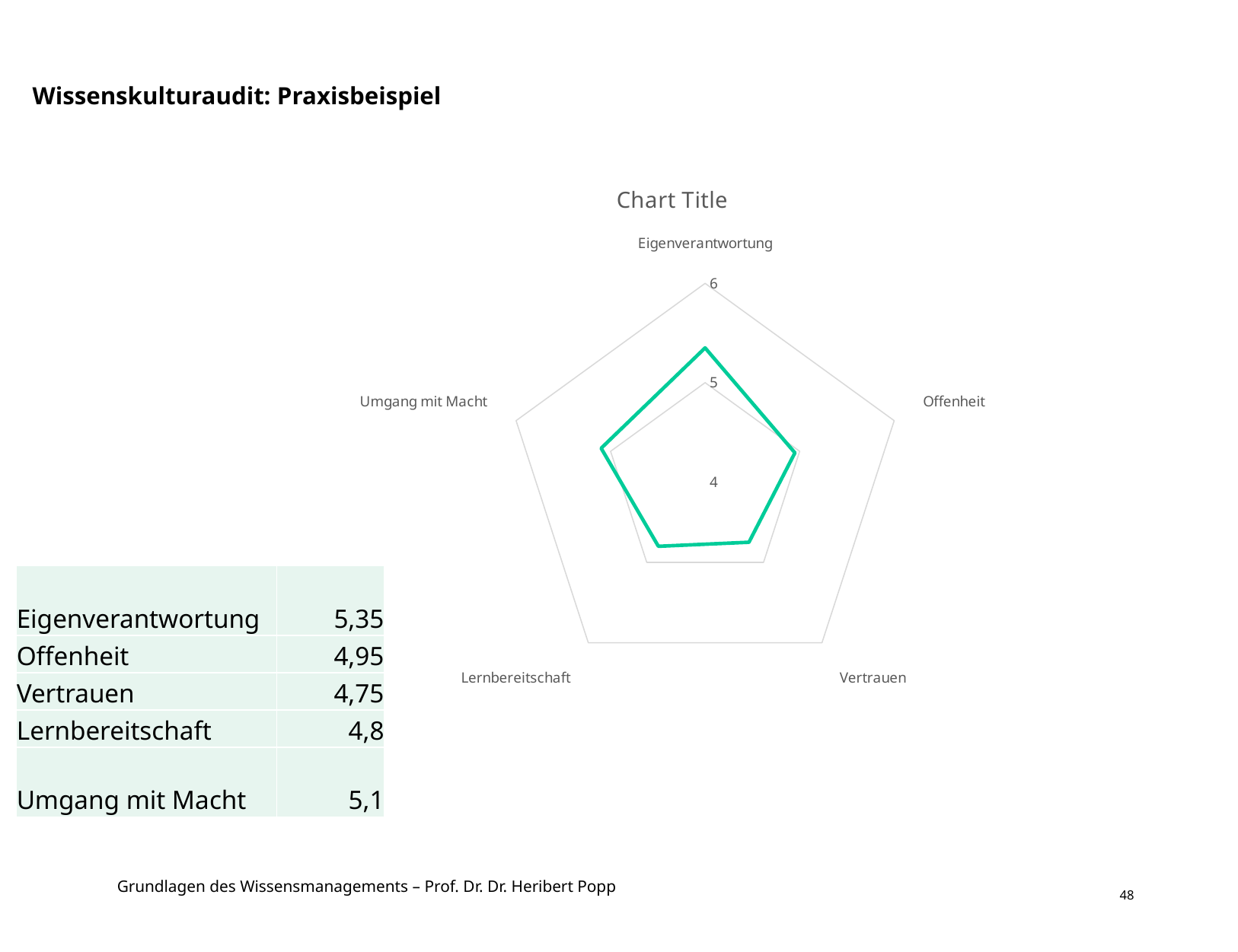
How many categories (axes) does the radar chart have? 5 Is the value for Lernbereitschaft greater or less than 5? less Which category has the lowest value? Vertrauen What kind of chart is shown on the slide? Radar chart What is the value for Umgang mit Macht? 5,1 Is the value for Eigenverantwortung greater or less than 5? greater Which category has the highest value? Eigenverantwortung What is the title shown above the radar chart? Chart Title What is the difference between the values for Eigenverantwortung and Vertrauen? 0,6 What is the value for Vertrauen? 4,75 Which is larger, the value for Offenheit or the value for Umgang mit Macht? Umgang mit Macht What is the value for Eigenverantwortung? 5,35